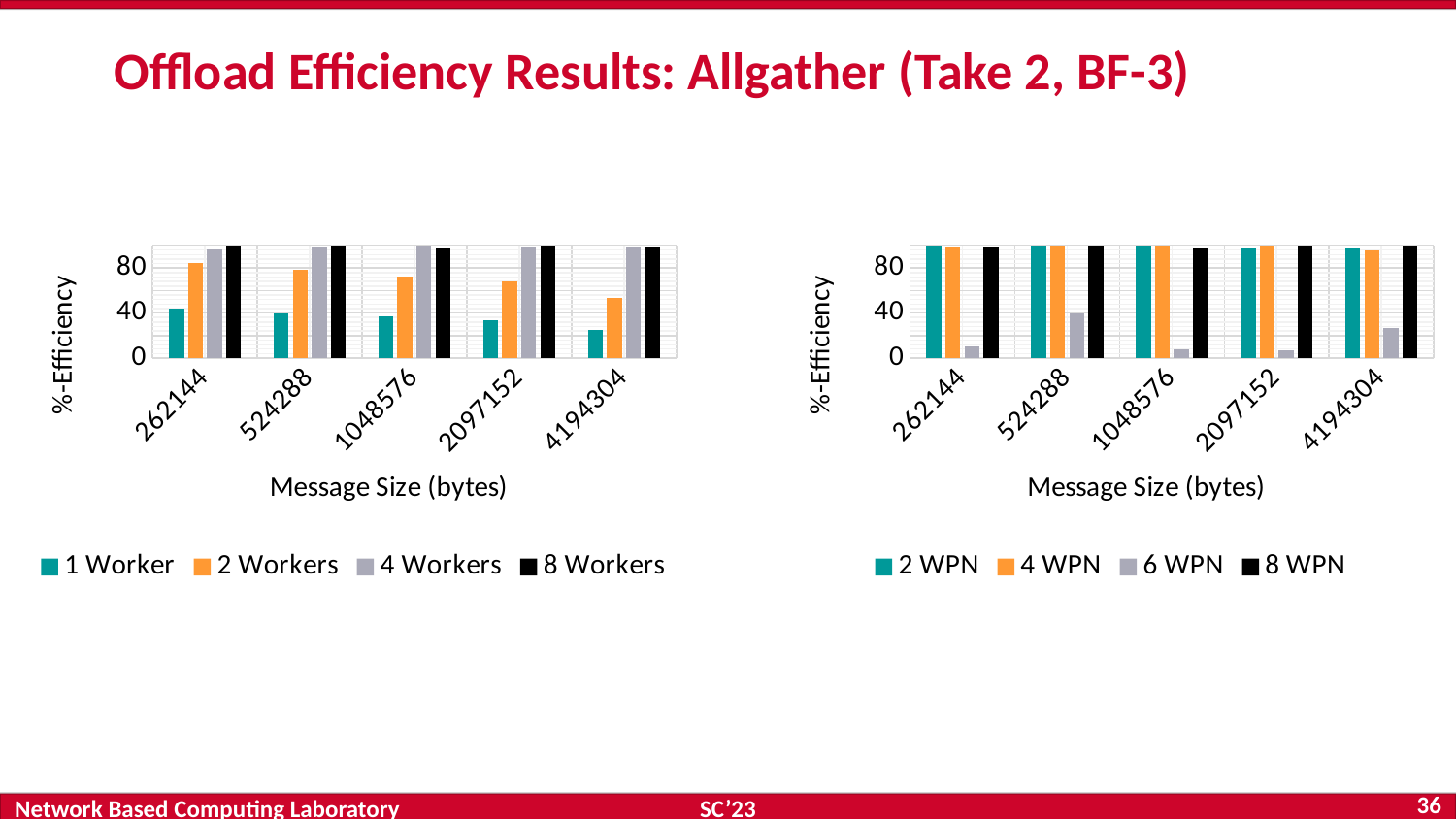
How many series does the legend of the right chart list? 4 In the left chart, is the value for 4 Workers at message size 262144 greater or less than 80? greater What is the x-axis title of the right chart? Message Size (bytes) What type of chart is the left chart on the slide? bar chart In the left chart, which series has the lowest value at message size 4194304? 1 Worker In the left chart, do the 1 Worker values rise or fall as message size increases along the x axis? fall How many series does the legend of the left chart list? 4 In the right chart, which series has the lowest value at message size 1048576? 6 WPN In the right chart, is the value for 6 WPN at message size 262144 greater or less than 40? less How many message-size categories are shown on the x axis of the left chart? 5 In the left chart, is the value for 1 Worker at message size 4194304 greater or less than 40? less In the right chart, which is larger for 6 WPN: the value at 262144 or the value at 524288? 524288